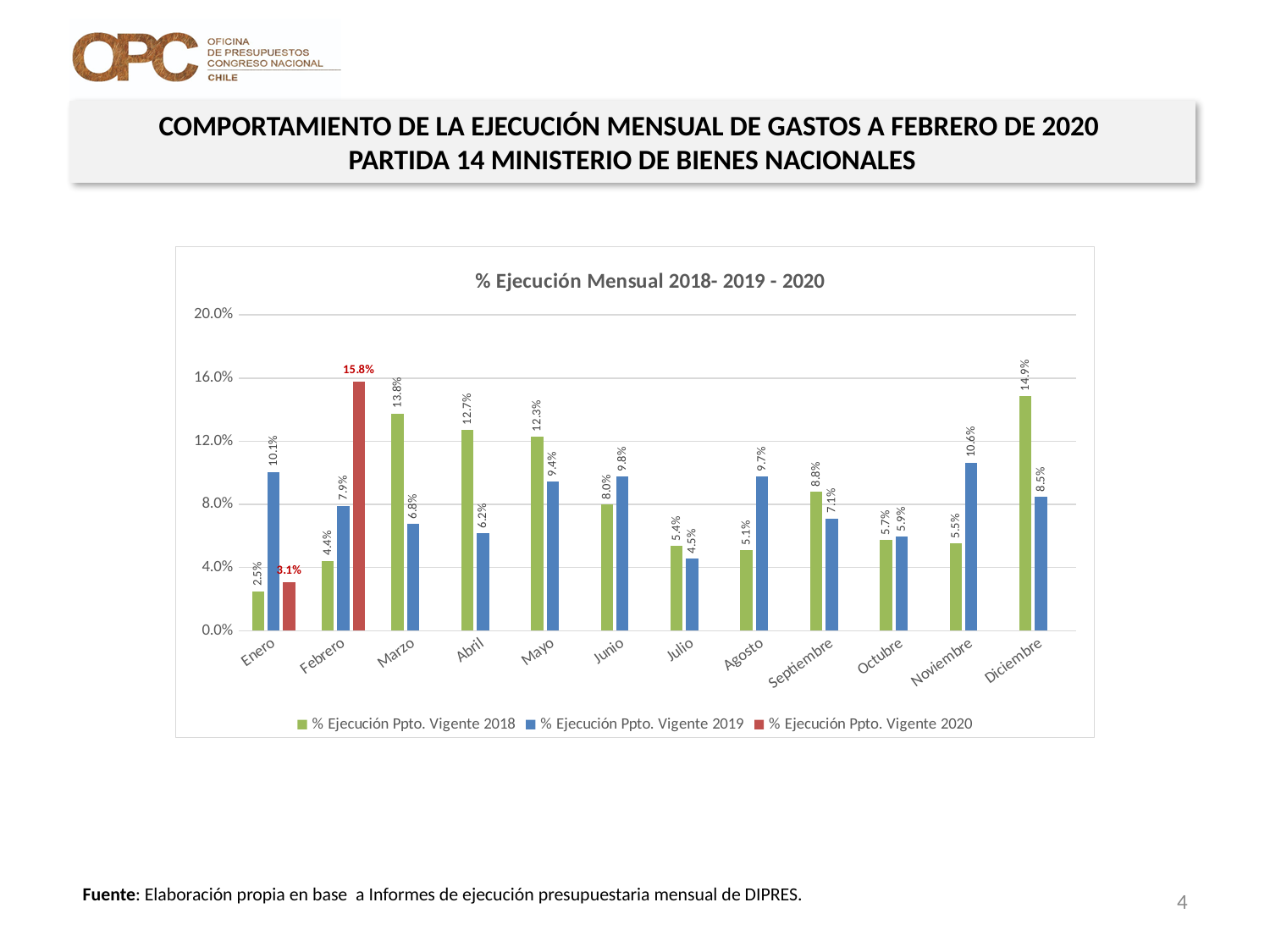
What is the value of % Ejecución Ppto. Vigente 2020 for Febrero? 15.8% What is the value of % Ejecución Ppto. Vigente 2019 for Noviembre? 10.6% What is the difference between the 2020 and 2019 values for Febrero? 7.9% How many months are shown on the x axis? 12 What is the title of the chart? % Ejecución Mensual 2018- 2019 - 2020 For Enero, which series has the larger value: % Ejecución Ppto. Vigente 2018 or % Ejecución Ppto. Vigente 2019? % Ejecución Ppto. Vigente 2019 Is the value of % Ejecución Ppto. Vigente 2018 for Marzo greater or less than 12.0%? greater What kind of chart is shown on the slide? Bar chart Which month has the lowest value for % Ejecución Ppto. Vigente 2019? Julio What is the value of % Ejecución Ppto. Vigente 2018 for Diciembre? 14.9% Which month has the highest value for % Ejecución Ppto. Vigente 2018? Diciembre How many series does the legend list? 3